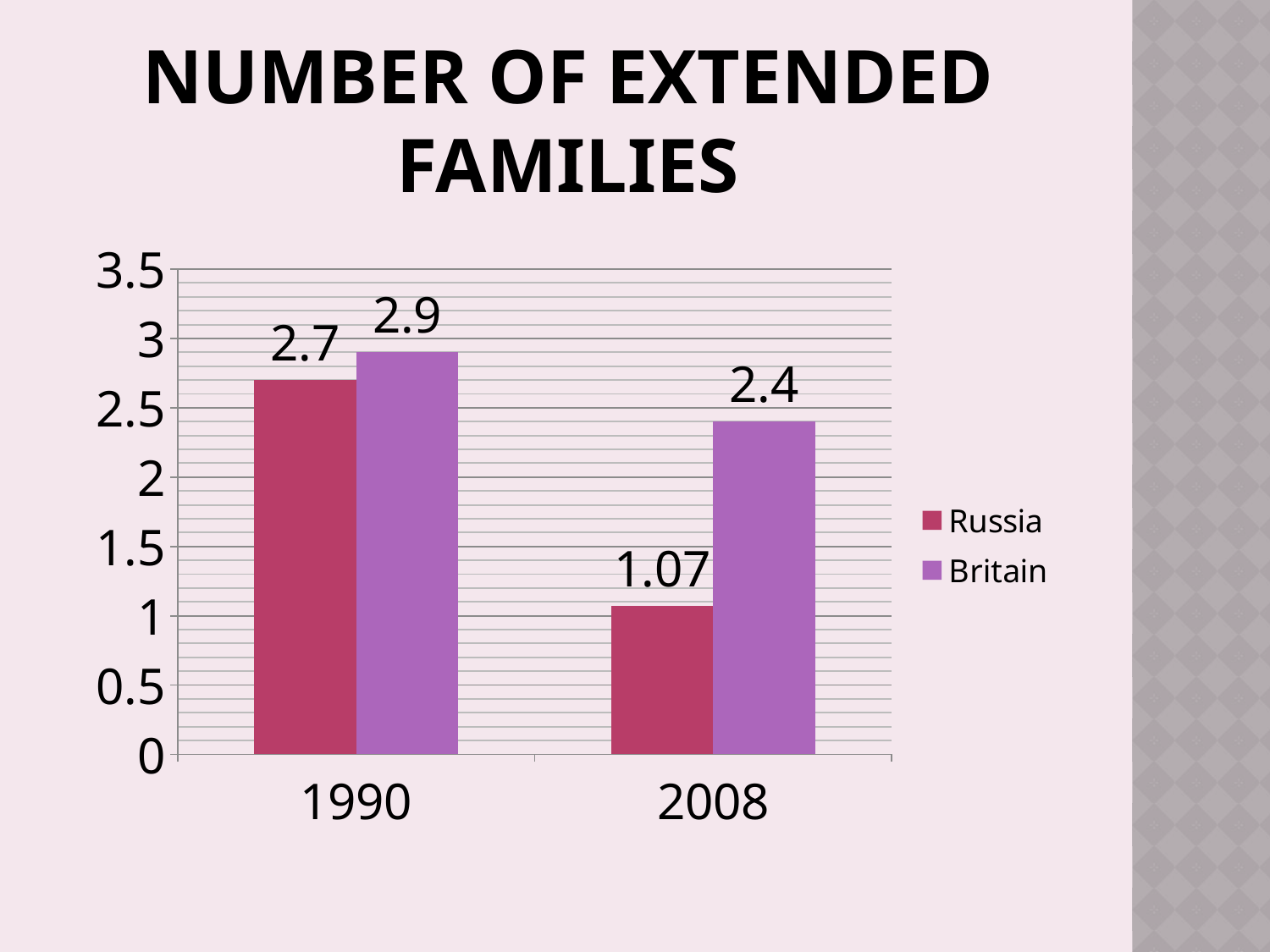
What is the value for Russia in 2008? 1.07 Which bar has the lowest value on the chart? Russia in 2008 What kind of chart is shown on the slide? Bar chart Which series has the highest value in 1990? Britain What is the difference between Russia's value in 1990 and in 2008? 1.63 Which is larger, Russia in 1990 or Britain in 2008? Russia in 1990 What is the value for Russia in 1990? 2.7 How many series does the legend list? 2 How many years are shown on the x axis? 2 What is the value for Britain in 2008? 2.4 What is the value for Britain in 1990? 2.9 What is the difference between Britain and Russia in 2008? 1.33